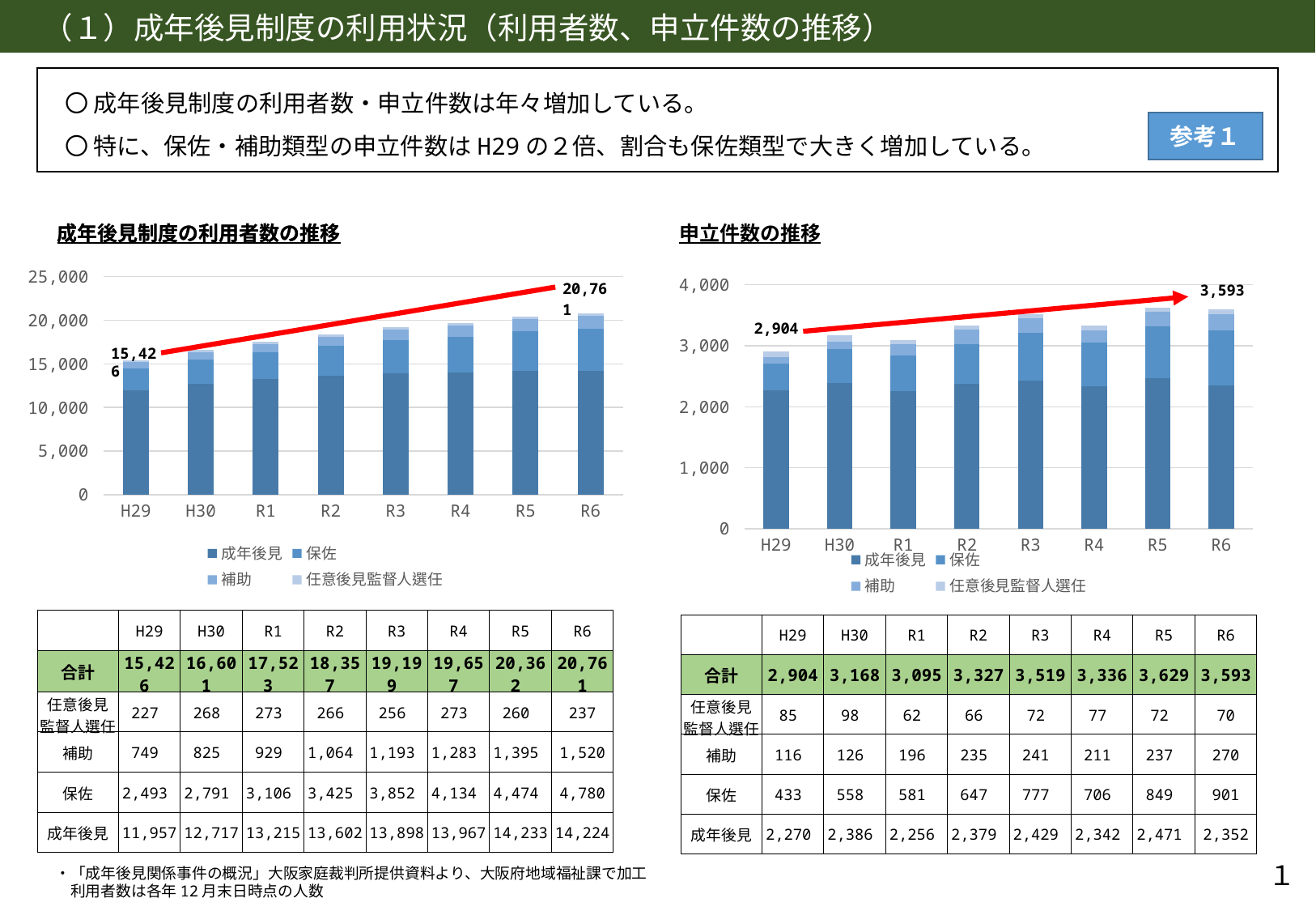
In the chart titled 成年後見制度の利用者数の推移, what is the total value for R6? 20,761 In the chart titled 申立件数の推移, what is the 保佐 value for R6? 901 In the chart titled 申立件数の推移, which year has the lowest total? H29 What kind of chart is the chart titled 申立件数の推移? stacked bar chart In the chart titled 成年後見制度の利用者数の推移, how many series does the legend list? 4 In the chart titled 成年後見制度の利用者数の推移, what is the total value for H29? 15,426 In the chart titled 成年後見制度の利用者数の推移, what is the 成年後見 value for R3? 13,898 In the chart titled 申立件数の推移, which year has the highest total? R5 In the chart titled 申立件数の推移, what is the total value for R5? 3,629 In the chart titled 成年後見制度の利用者数の推移, do the total values rise or fall from H29 to R6? rise In the chart titled 申立件数の推移, how many years are shown on the x axis? 8 In the chart titled 成年後見制度の利用者数の推移, by how much does the total for R6 exceed the total for H29? 5,335